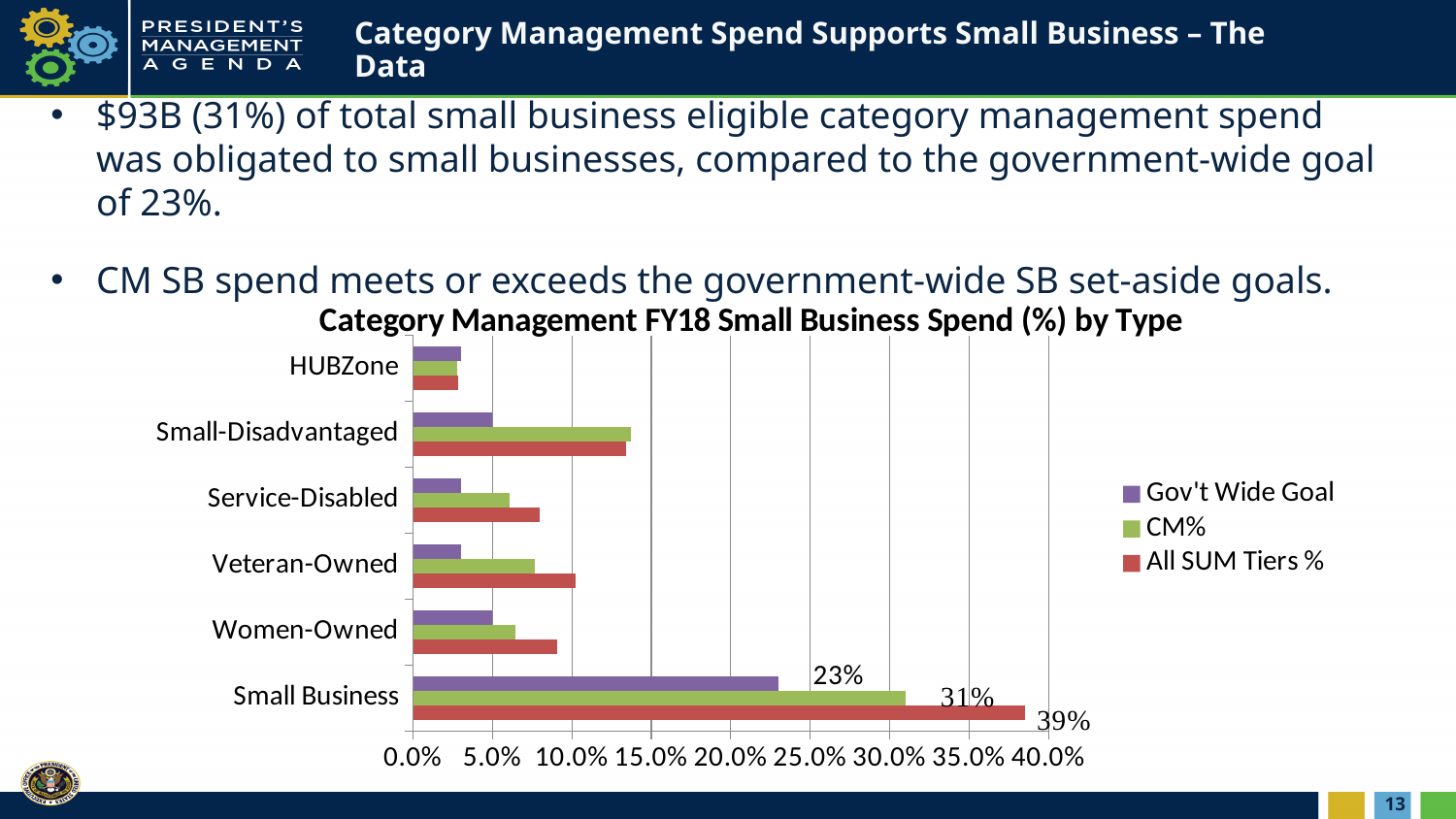
What is the title of the chart? Category Management FY18 Small Business Spend (%) by Type How many series does the chart legend list? 3 What is the CM% value for Small Business? 31% What is the All SUM Tiers % value for Small Business? 39% How many categories are shown on the chart's vertical axis? 6 What is the difference between the All SUM Tiers % and the Gov't Wide Goal for Small Business? 16% Which category has the lowest CM% value? HUBZone What is the Gov't Wide Goal value for Small Business? 23% What type of chart is shown on the slide? Bar chart For Service-Disabled, which is larger: the CM% value or the All SUM Tiers % value? All SUM Tiers % Which category has the highest All SUM Tiers % value? Small Business Is the CM% value for Small-Disadvantaged greater or less than 10.0%? greater